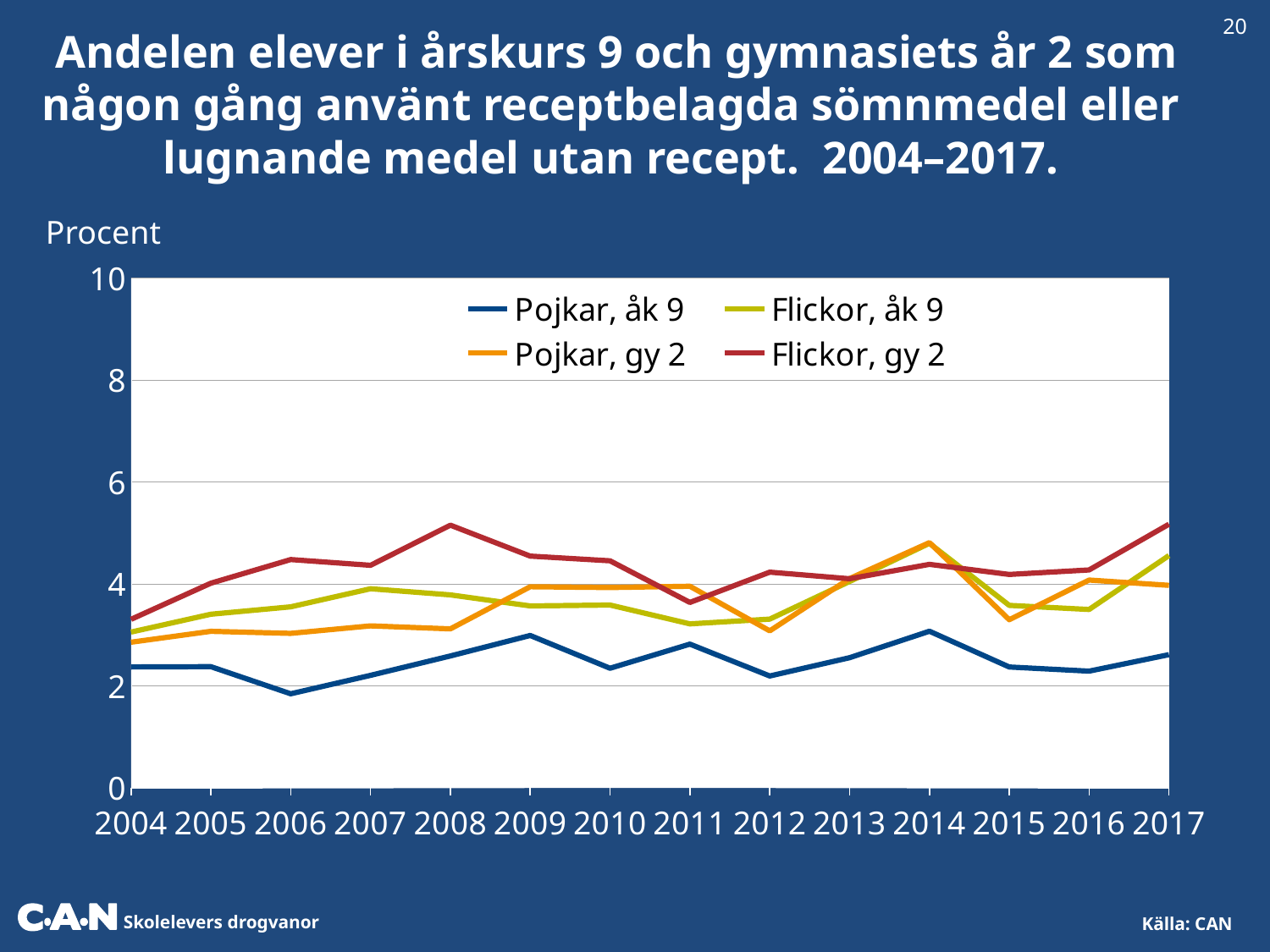
How many series does the legend list? 4 In 2014, which is larger: Pojkar, gy 2 or Pojkar, åk 9? Pojkar, gy 2 How many years are shown on the x axis? 14 What label is shown above the y axis of the chart? Procent Is the value for Pojkar, åk 9 in 2006 greater or less than 2? less What kind of chart is shown on the slide? line chart In which year does the Pojkar, åk 9 line reach its lowest value? 2006 Which series has the highest value in 2008? Flickor, gy 2 Which series has the lowest value in 2017? Pojkar, åk 9 Is the value for Flickor, gy 2 in 2008 greater or less than 4? greater Does the Flickor, gy 2 line rise or fall from 2015 to 2017? rise Is the value for Pojkar, gy 2 in 2014 greater or less than 4? greater